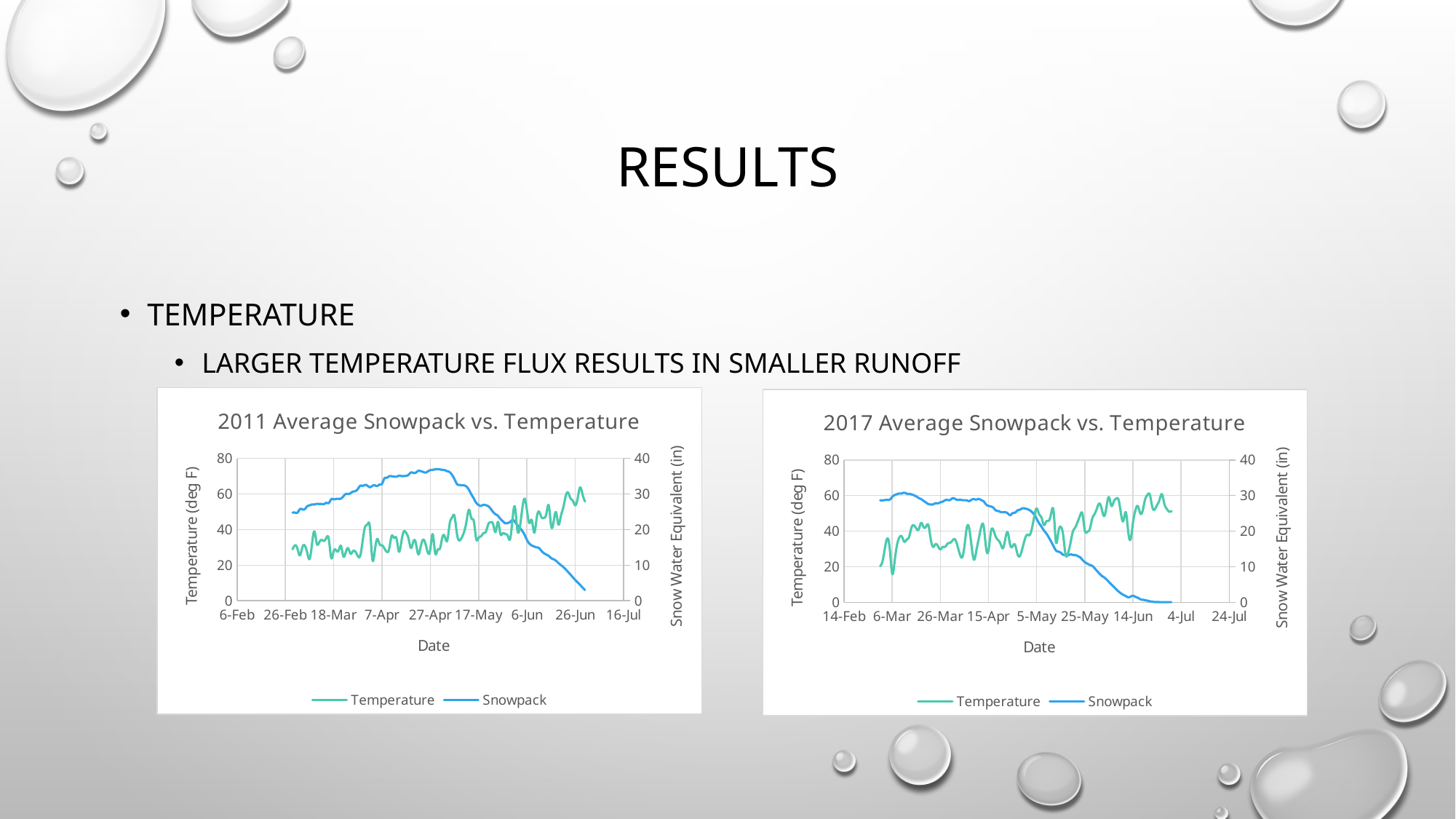
In the 2011 Average Snowpack vs. Temperature chart, does the Snowpack series rise or fall between 27-Apr and 26-Jun? fall What is the title of the chart on the left side of the slide? 2011 Average Snowpack vs. Temperature In the 2011 Average Snowpack vs. Temperature chart, is the Snowpack value at 26-Jun greater or less than 10 inches? less What kind of chart is the 2011 Average Snowpack vs. Temperature chart? line chart In the 2017 Average Snowpack vs. Temperature chart, does the Snowpack series generally rise or fall from 6-Mar to 4-Jul? fall In the 2017 Average Snowpack vs. Temperature chart, does the Temperature series generally rise or fall from 6-Mar to 14-Jun? rise How many series does the legend of the 2017 Average Snowpack vs. Temperature chart list? 2 In the 2017 Average Snowpack vs. Temperature chart, is the Snowpack value at 14-Jun greater or less than 10 inches? less What is the label of the right-hand vertical axis on the 2017 Average Snowpack vs. Temperature chart? Snow Water Equivalent (in)